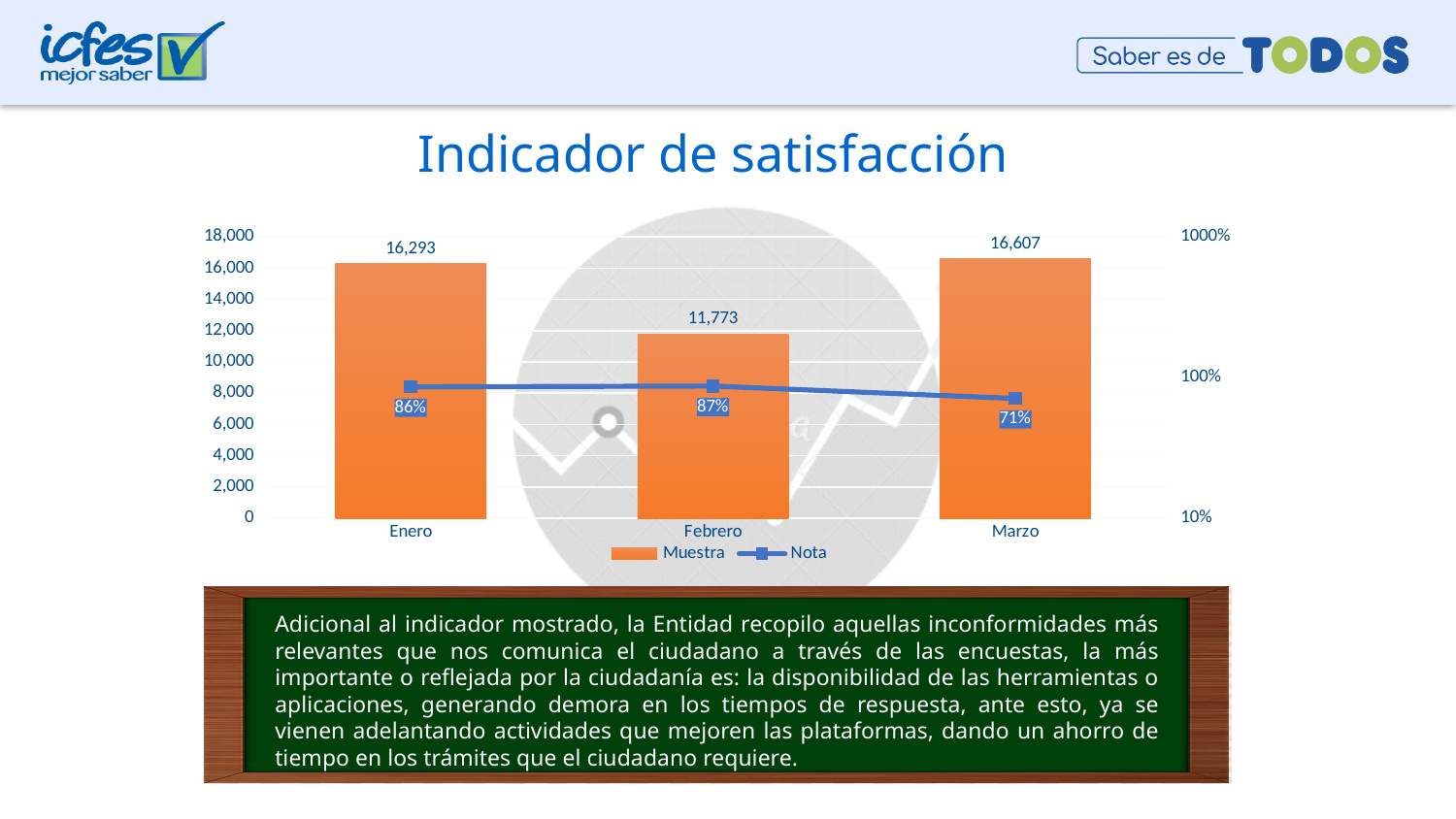
How many series does the legend list? 2 What is the Muestra value for Enero? 16,293 What is the Nota value for Febrero? 87% What is the Muestra value for Febrero? 11,773 How many months are shown on the x axis? 3 Which month has the highest Muestra value? Marzo Which month has the lowest Nota value? Marzo What is the title of the chart? Indicador de satisfacción Which is larger, the Muestra value for Enero or for Febrero? Enero What kind of chart is shown on the slide? Combined bar and line chart What is the Nota value for Marzo? 71% What is the difference between the Muestra values for Marzo and Enero? 314